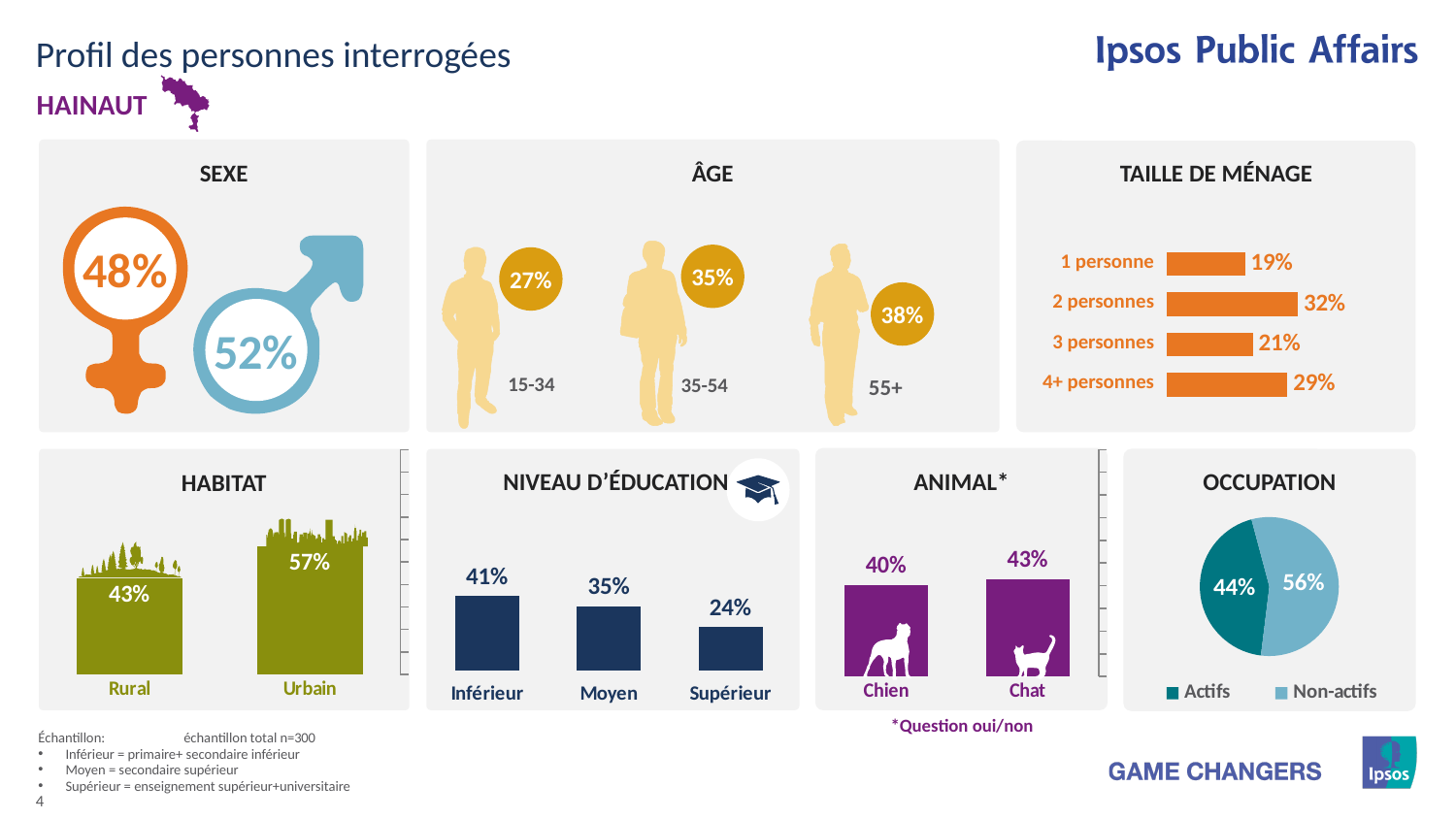
In the NIVEAU D'ÉDUCATION chart, which category has the highest value? Inférieur In the ANIMAL chart, what is the difference between Chat and Chien? 3% In the OCCUPATION chart, what share of the pie is Non-actifs? 56% In the NIVEAU D'ÉDUCATION chart, what is the value for Moyen? 35% What kind of chart is the OCCUPATION chart? pie chart In the TAILLE DE MÉNAGE chart, how many categories are shown? 4 In the TAILLE DE MÉNAGE chart, what is the value for 2 personnes? 32% In the TAILLE DE MÉNAGE chart, which household size has the lowest value? 1 personne In the HABITAT chart, which is larger, Rural or Urbain? Urbain In the TAILLE DE MÉNAGE chart, what is the difference between 2 personnes and 3 personnes? 11% In the NIVEAU D'ÉDUCATION chart, do the values rise or fall from Inférieur to Supérieur? fall In the HABITAT chart, what is the value for Urbain? 57%